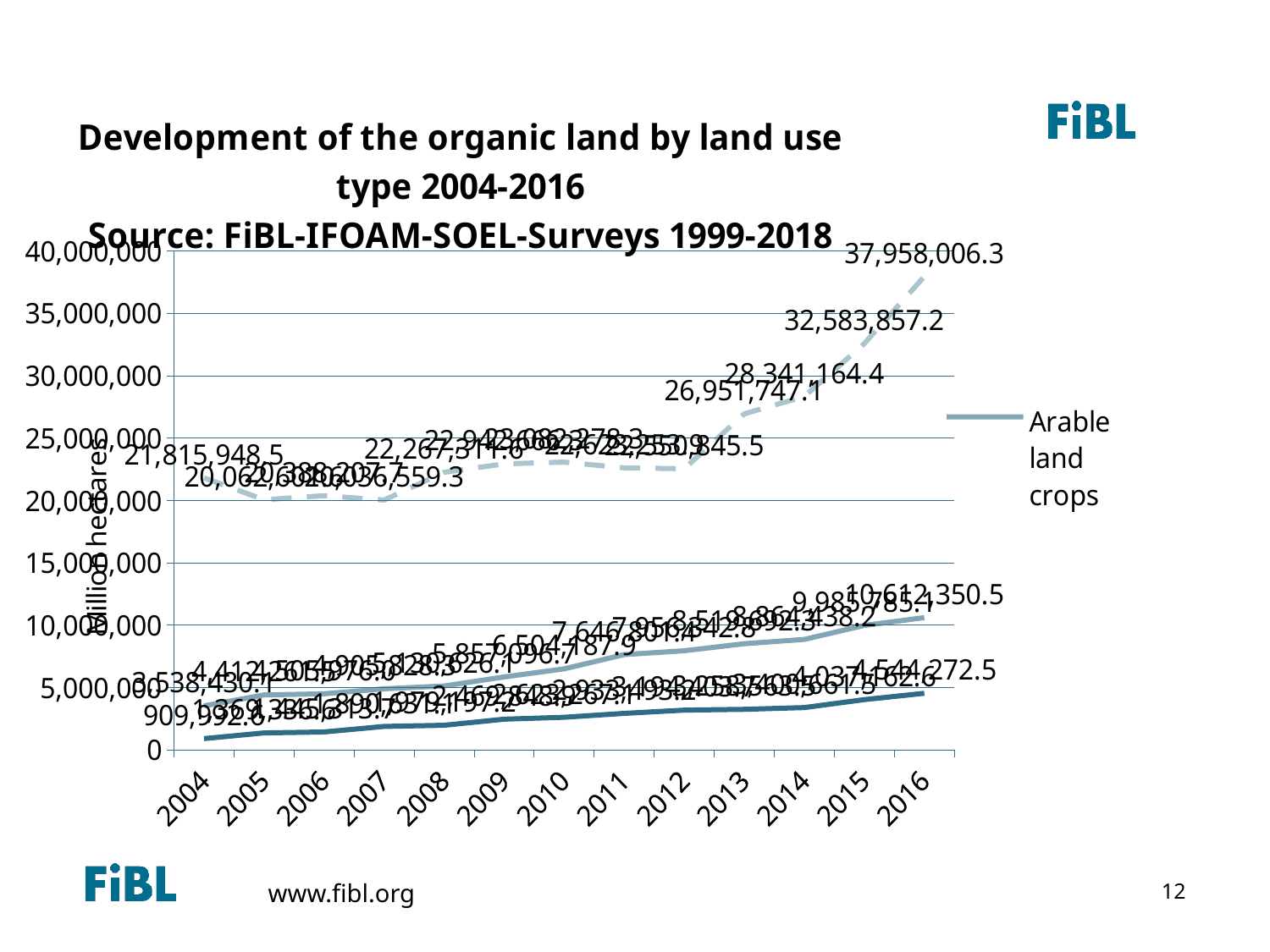
What is the value labelled on the top dashed line for 2014? 28,341,164.4 Is the top dashed line's value for 2005 greater or less than 25,000,000? less What is the value labelled on the top dashed line for 2013? 26,951,747.1 How many years are shown along the x axis of the chart? 13 Which legend entry is readable on the right of the chart? Arable land crops Does the top dashed line rise or fall between 2012 and 2016? rises What is the value labelled on the top dashed line for 2015? 32,583,857.2 What is the first year and the last year shown on the x axis? 2004 and 2016 Is the top dashed line's value for 2016 greater or less than 35,000,000? greater What kind of chart is shown on the slide? line chart What is the difference between the top dashed line's 2016 value (37,958,006.3) and its 2015 value (32,583,857.2)? 5,374,149.1 What is the largest value labelled on the chart (the top dashed line in 2016)? 37,958,006.3